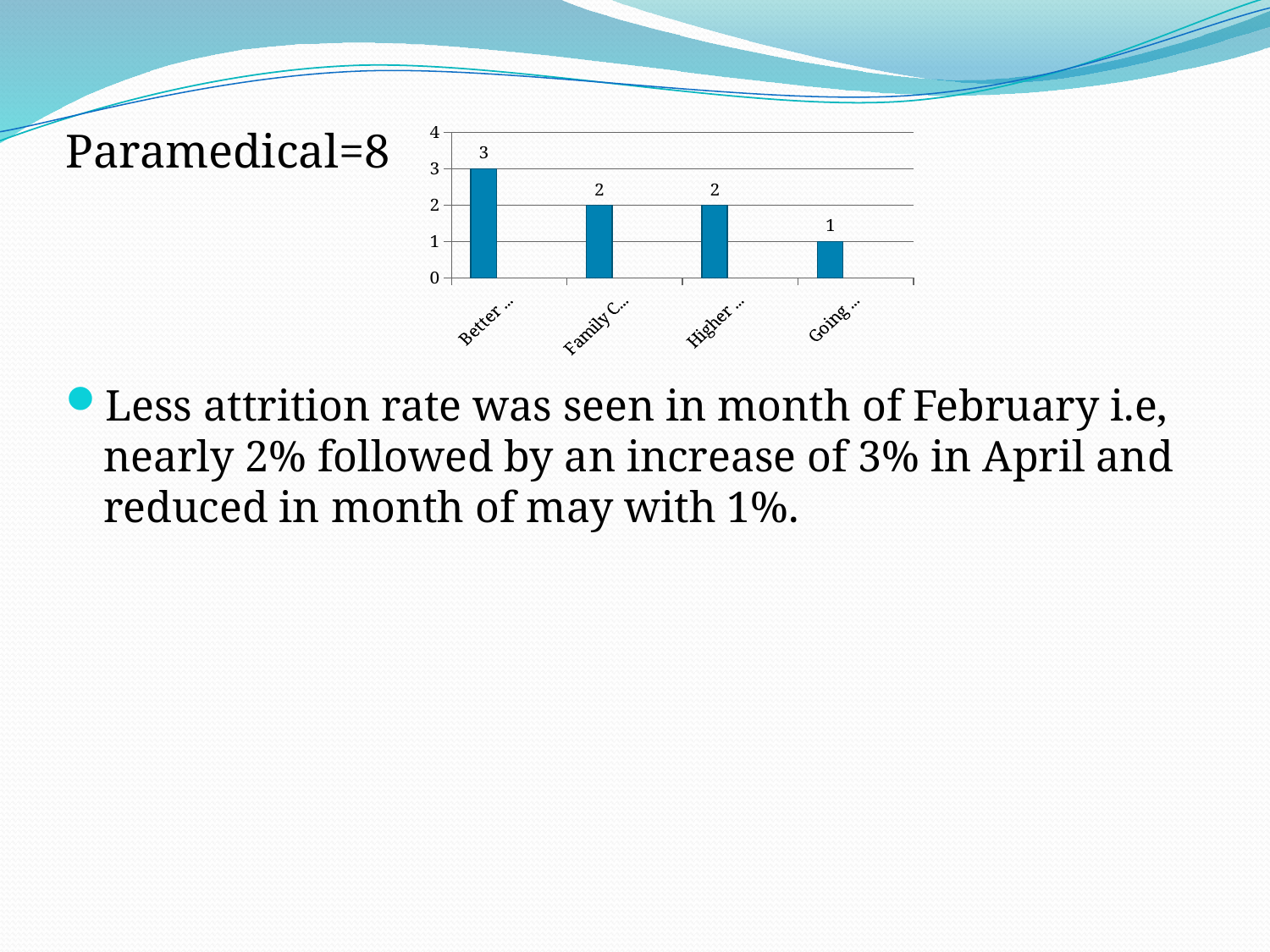
Which bar has the highest value? Better ... What is the value of the first bar (labelled "Better ...")? 3 Which is larger, the value for "Higher ..." or the value for "Going ..."? Higher ... How many bars are plotted in the chart? 4 What is the difference between the first bar ("Better ...") and the last bar ("Going ...")? 2 Do the bar values generally rise or fall from left to right? fall What is the value of the last bar (labelled "Going ...")? 1 What is the maximum value shown on the vertical axis? 4 What is the value of the second bar (labelled "Family C...")? 2 What type of chart is shown on the slide? bar chart Which bar has the lowest value? Going ... What is the total of all four bar values? 8